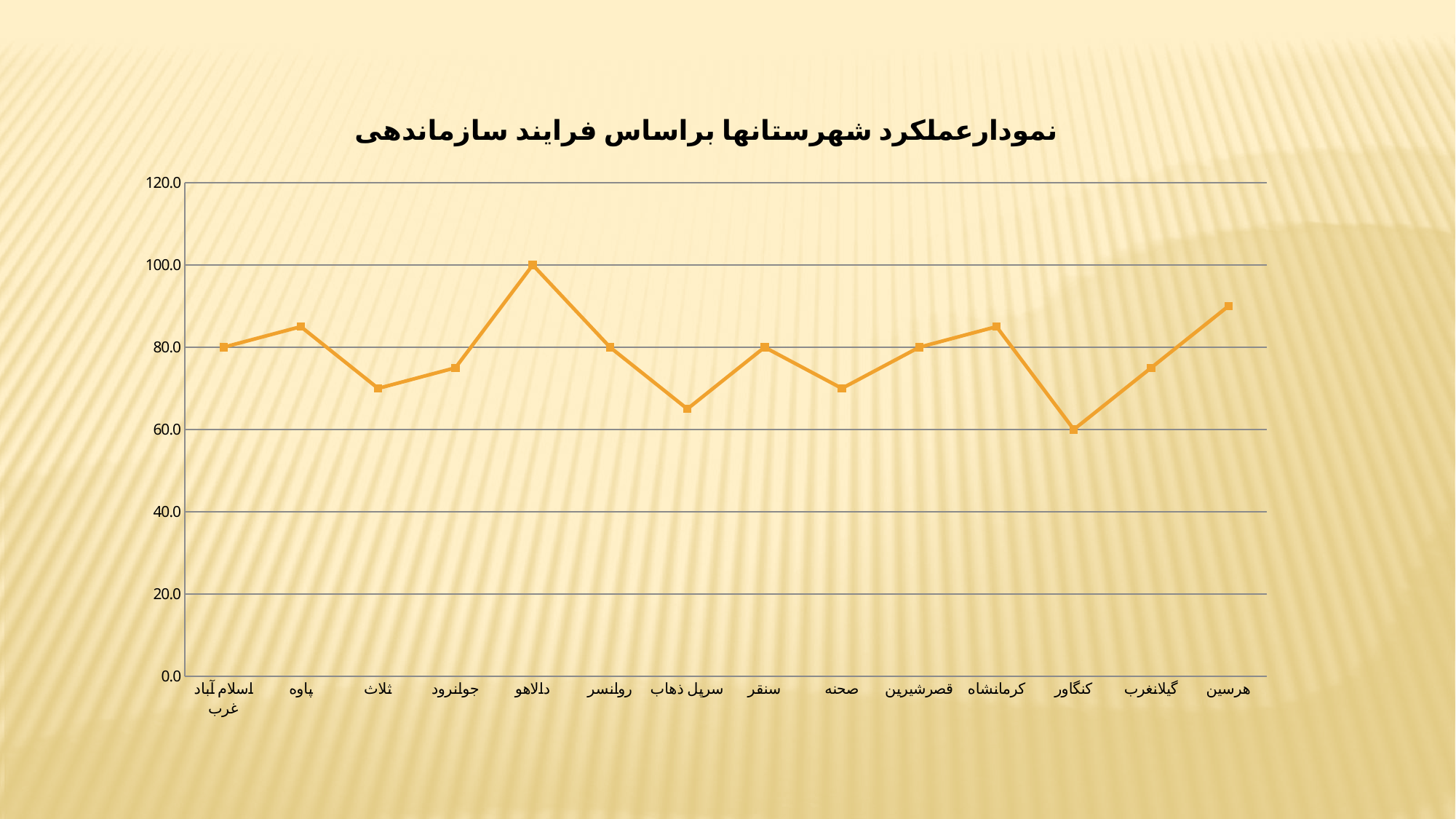
What kind of chart is shown on the slide? line chart Is the value for سرپل ذهاب greater or less than 80? less What is the value for کنگاور? 60.0 What is the value for دالاهو? 100.0 Which is larger, the value for هرسین or the value for گیلانغرب? هرسین What is the title of the chart? نمودارعملکرد شهرستانها براساس فرایند سازماندهی What is the difference between the values for دالاهو and کنگاور? 40.0 How many categories are plotted along the x axis? 14 Is the value for پاوه greater or less than 80? greater Which category has the highest value? دالاهو Which category has the lowest value? کنگاور What is the value for اسلام آباد غرب? 80.0